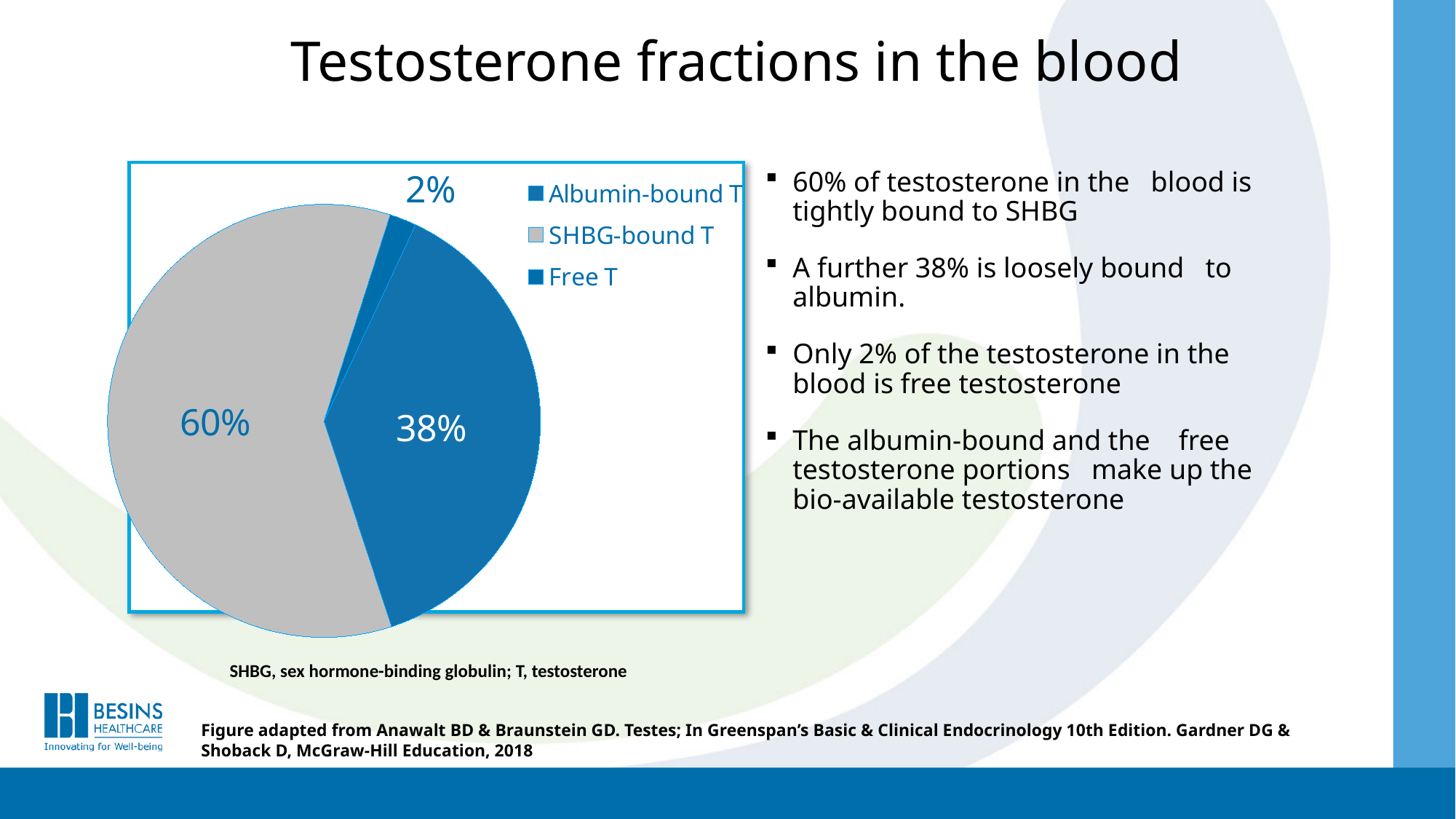
What percentage of testosterone is SHBG-bound T according to the pie chart? 60% How many slices does the pie chart have? 3 How many entries does the legend list? 3 Which fraction has the smallest share of the pie chart? Free T What is the combined share of Albumin-bound T and Free T in the pie chart? 40% What percentage of testosterone is Albumin-bound T according to the pie chart? 38% What colour is the SHBG-bound T slice in the pie chart? Grey Which is larger, the Albumin-bound T slice or the Free T slice? Albumin-bound T What is the difference in percentage points between SHBG-bound T and Albumin-bound T? 22 What percentage of testosterone is Free T according to the pie chart? 2% Which fraction has the largest share of the pie chart? SHBG-bound T What kind of chart is shown on the slide? Pie chart